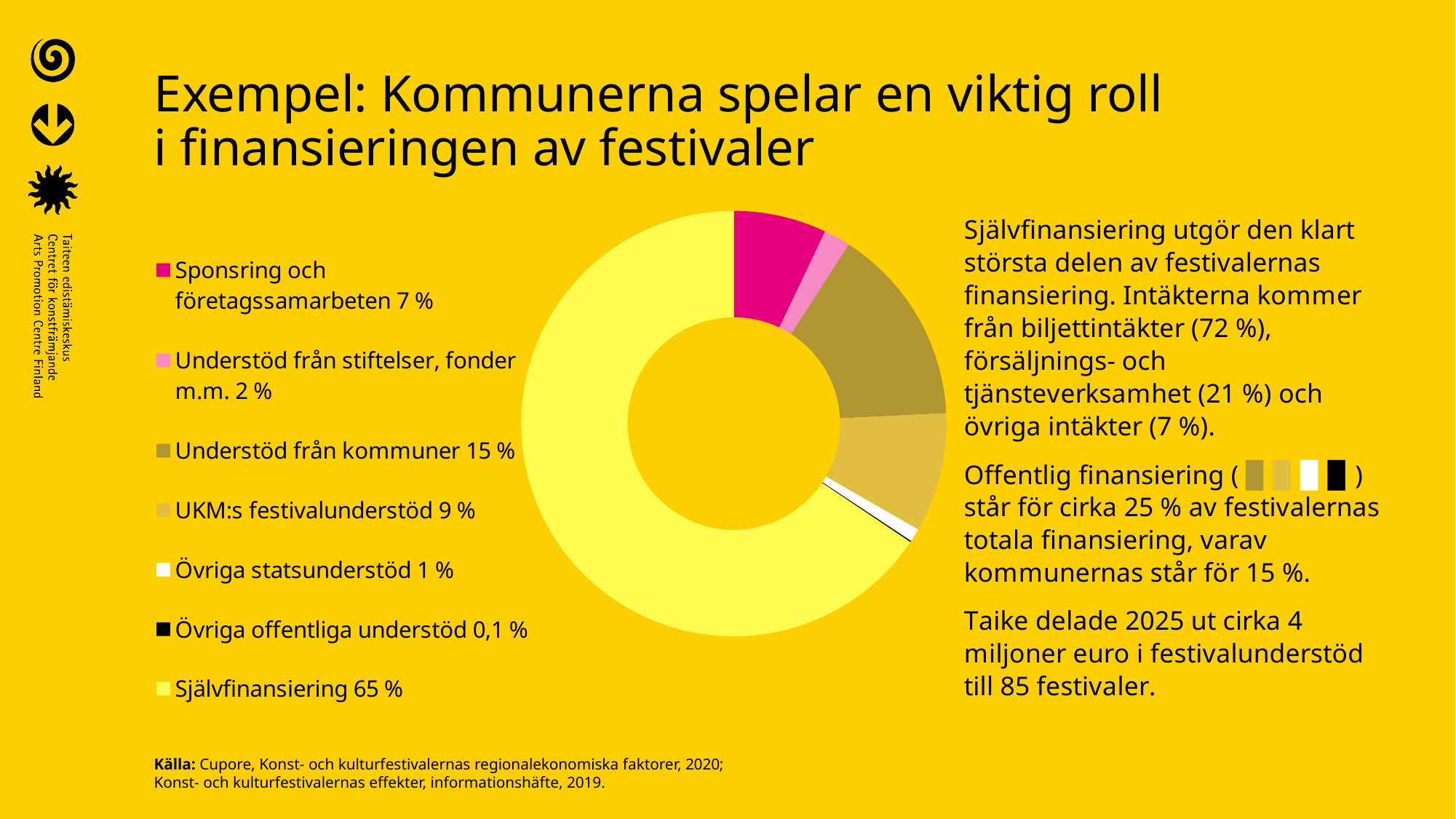
What is the difference between Självfinansiering and Understöd från kommuner? 50 % What is the value for Sponsring och företagssamarbeten? 7 % Which is larger, Understöd från kommuner or UKM:s festivalunderstöd? Understöd från kommuner Which category has the smallest share of the chart? Övriga offentliga understöd What share of festival financing does Självfinansiering account for? 65 % How many categories does the chart's legend list? 7 What kind of chart is shown on the slide? Pie chart (donut) What colour is the Sponsring och företagssamarbeten slice? Magenta (pink) What is the value for Övriga offentliga understöd? 0,1 % What is the value for UKM:s festivalunderstöd? 9 % Which category has the largest share of the chart? Självfinansiering What is the value for Understöd från kommuner? 15 %